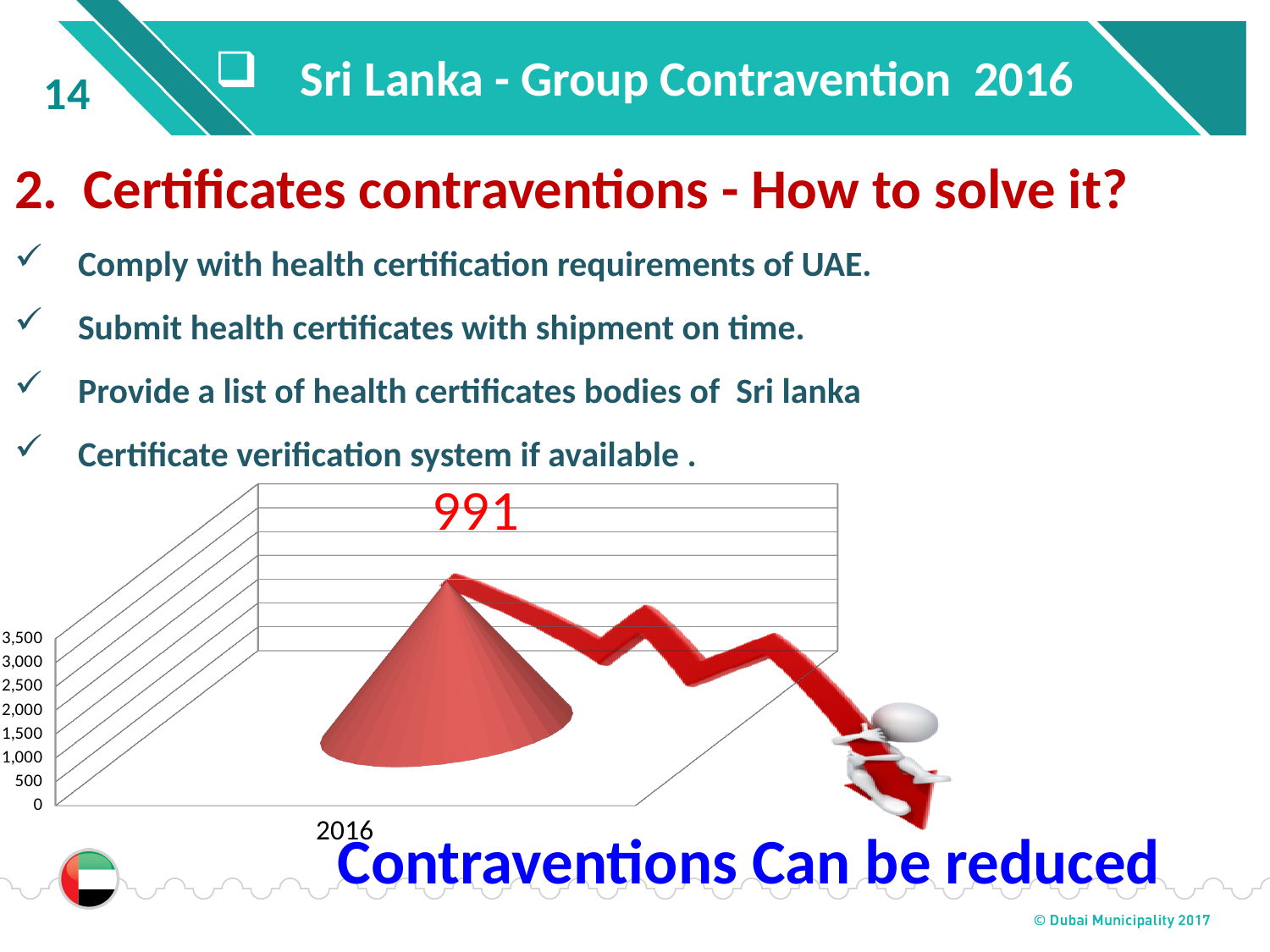
What is the highest tick value shown on the vertical axis of the chart? 3,500 What is the value shown for 2016 in the chart? 991 Is the value for 2016 greater or less than 500? greater Which year is labelled on the x axis of the chart? 2016 What kind of chart is shown on the slide? bar chart How many categories are plotted on the x axis of the chart? 1